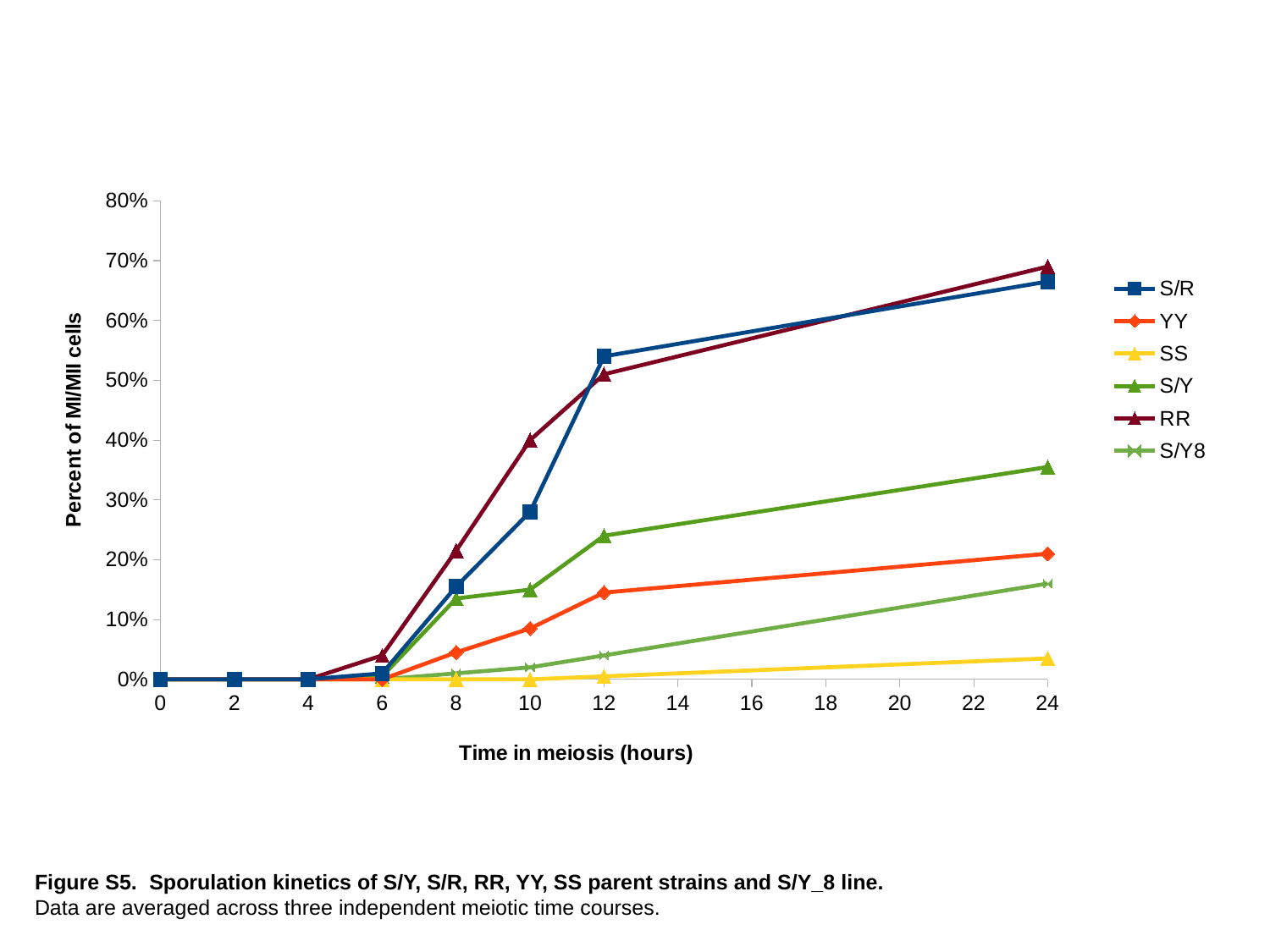
How many series does the legend list? 6 What is the label of the x axis? Time in meiosis (hours) Is the value for S/R at 12 hours greater or less than 50%? greater How many time points are plotted for each series? 8 Which series has the highest value at 10 hours? RR What kind of chart is shown on the slide? line chart Is the value for S/Y at 24 hours greater or less than 30%? greater Do the values for RR rise or fall as time in meiosis increases? rise Is the value for SS at 24 hours greater or less than 10%? less Which series has the lowest value at 24 hours? SS What is the value for S/R at 0 hours? 0% At 24 hours, which is larger, the value for S/Y or the value for YY? S/Y